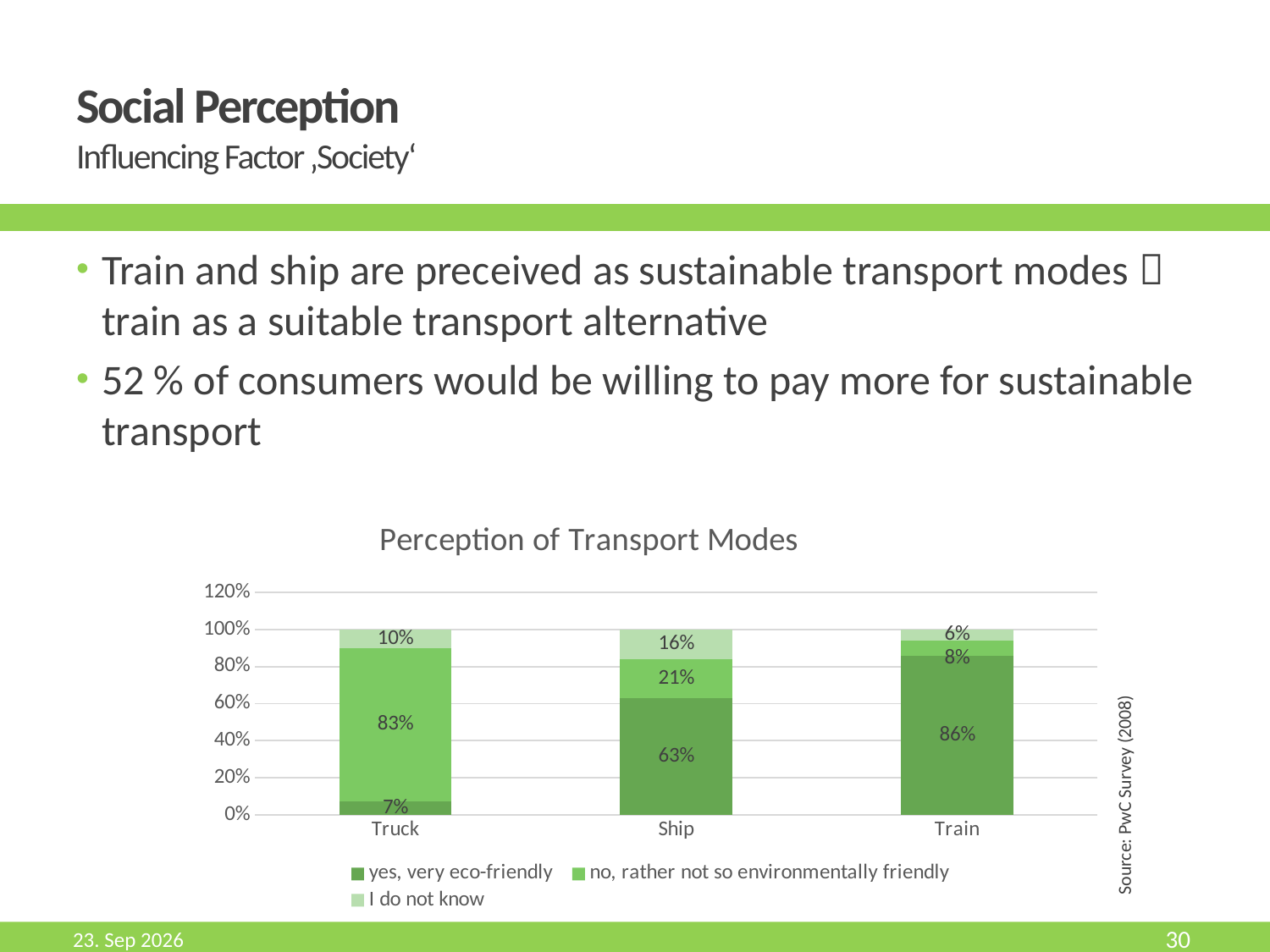
What is the difference between the 'yes, very eco-friendly' values for Train and Ship? 23% What kind of chart is shown on the slide? Stacked bar chart Which transport mode has the highest value for 'yes, very eco-friendly'? Train What is the value for 'I do not know' for Ship? 16% What is the total of the stacked bar for Train? 100% Which transport mode has the lowest value for 'yes, very eco-friendly'? Truck What is the value for 'no, rather not so environmentally friendly' for Truck? 83% Which is larger: the 'I do not know' value for Truck or for Ship? Ship What is the value for 'yes, very eco-friendly' for Train? 86% How many transport modes are shown on the x axis? 3 What is the value for 'yes, very eco-friendly' for Ship? 63% How many series does the legend list? 3